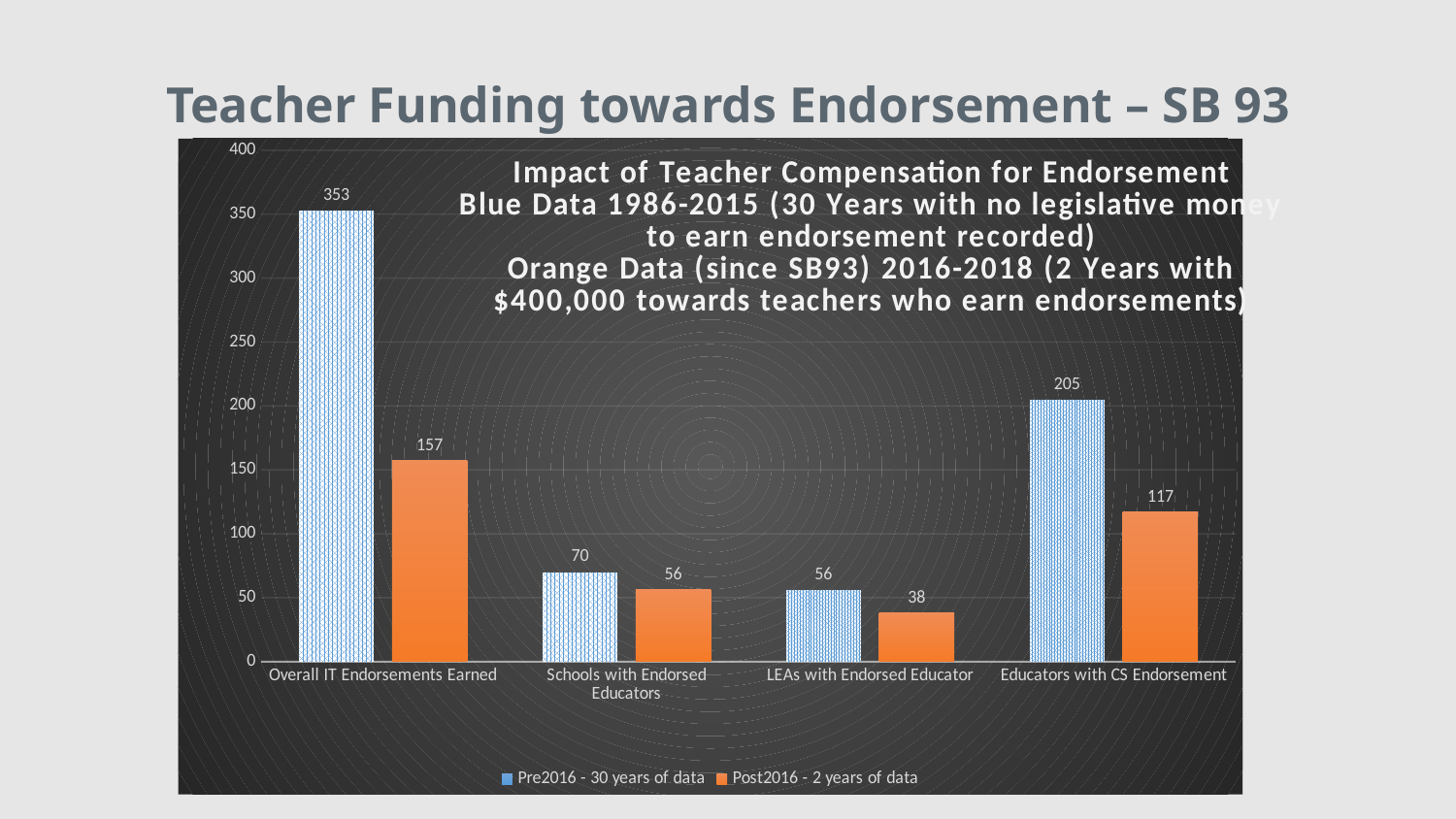
What is the Post2016 - 2 years of data value for Educators with CS Endorsement? 117 What kind of chart is shown on the slide? bar chart Is the Pre2016 value for Educators with CS Endorsement greater or less than 200? greater What is the Post2016 - 2 years of data value for LEAs with Endorsed Educator? 38 Which category has the lowest Post2016 - 2 years of data value? LEAs with Endorsed Educator How many categories are shown on the x axis? 4 Which category has the highest Pre2016 - 30 years of data value? Overall IT Endorsements Earned What is the difference between the Pre2016 and Post2016 values for Overall IT Endorsements Earned? 196 How many series does the legend list? 2 What is the Pre2016 - 30 years of data value for Overall IT Endorsements Earned? 353 Which is larger: the Pre2016 value for Schools with Endorsed Educators or the Post2016 value for Educators with CS Endorsement? Post2016 value for Educators with CS Endorsement What is the difference between the Pre2016 and Post2016 values for Educators with CS Endorsement? 88